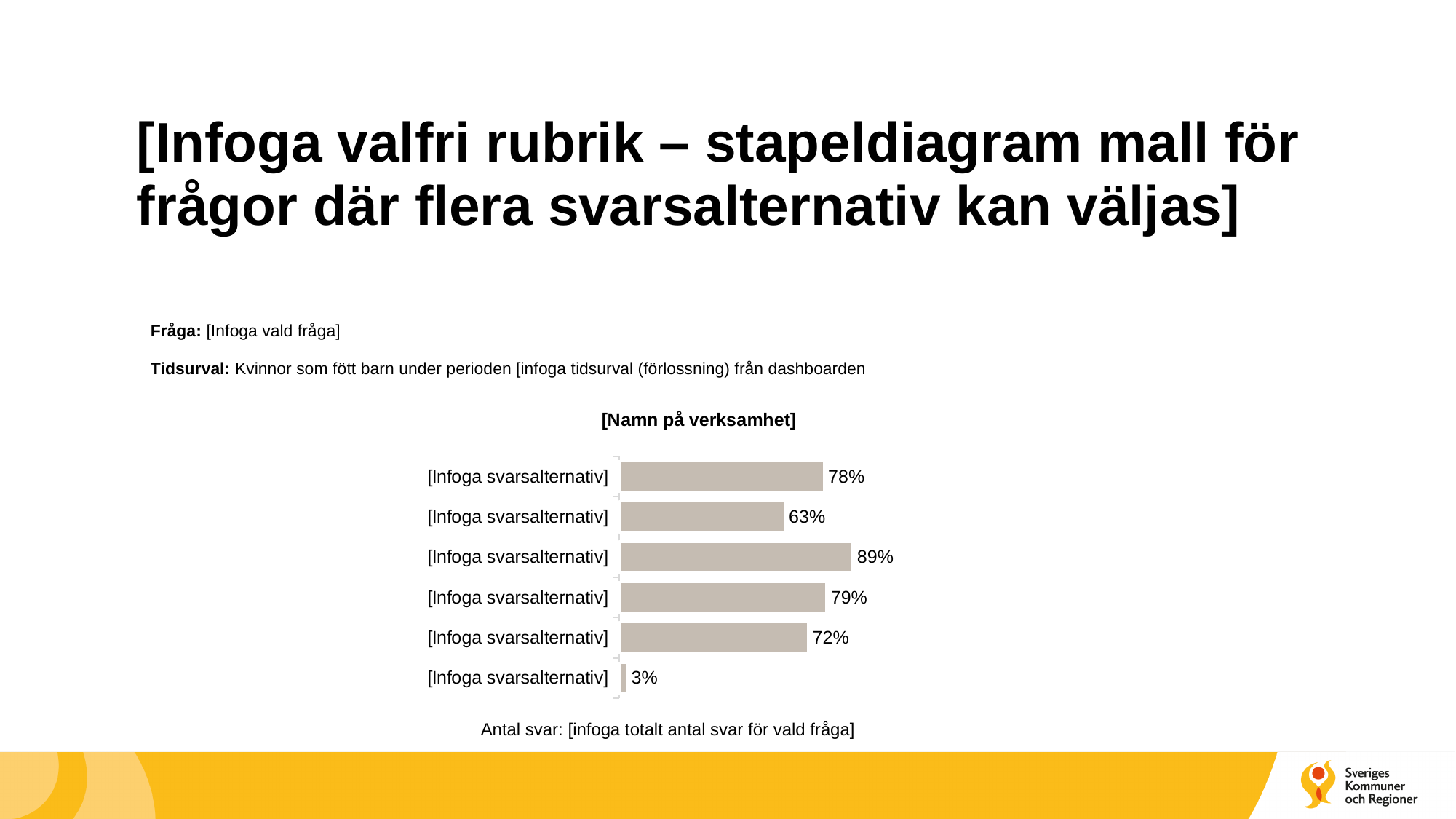
What is the highest value shown in the chart? 89% What kind of chart is shown on the slide? bar chart What is the value of the top bar in the chart? 78% Which bar has the highest value? the third bar from the top What is the difference between the highest value (89%) and the lowest value (3%)? 86 percentage points How many bars does the chart show? 6 What is the difference between the top bar (78%) and the second bar (63%)? 15 percentage points Which is larger, the value of the fourth bar from the top or the value of the fifth bar from the top? the fourth bar (79%) What is the value of the second bar from the top? 63% What is the title of the chart? [Namn på verksamhet] What is the value of the bottom bar in the chart? 3% What is the lowest value shown in the chart? 3%